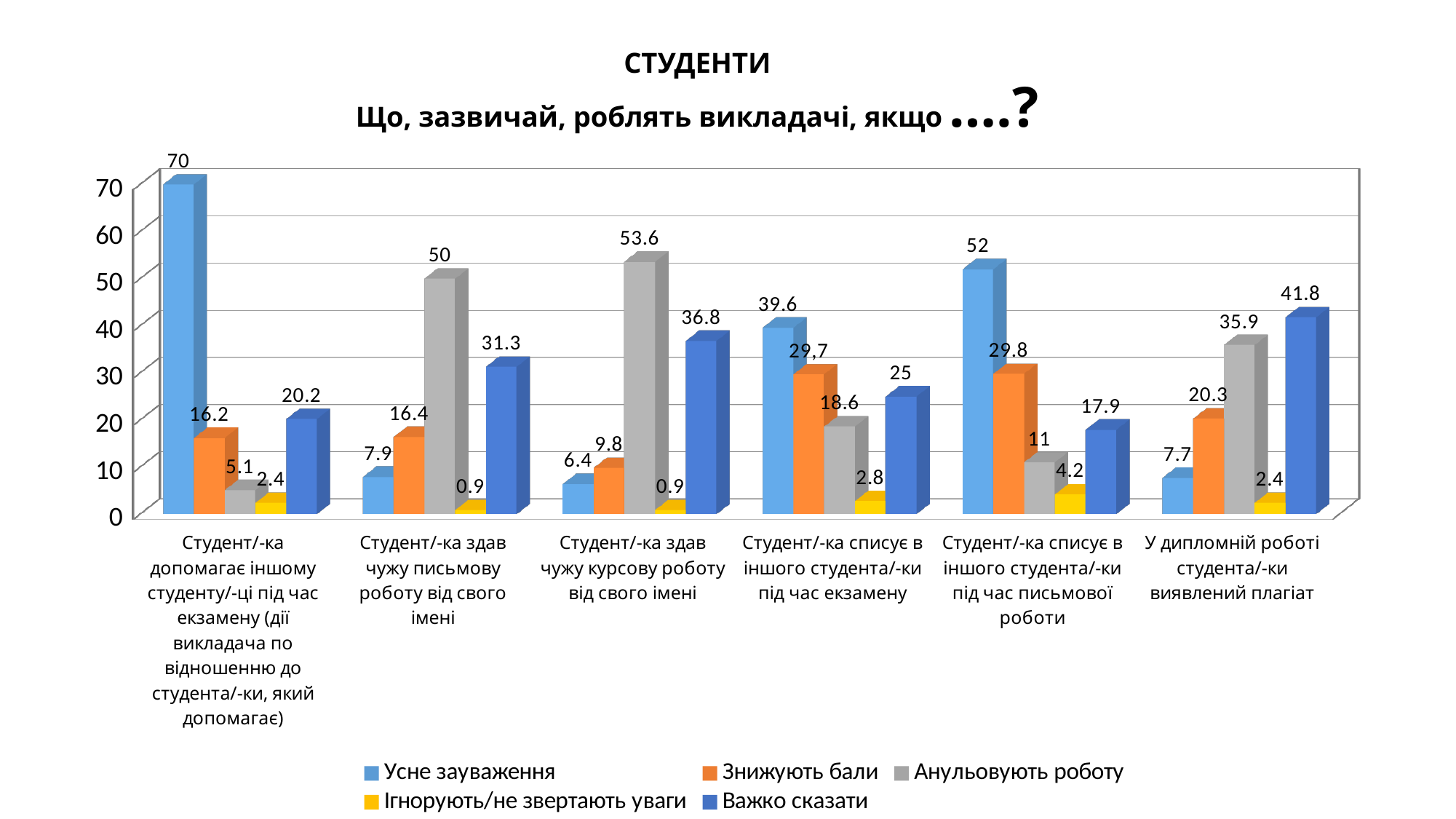
What is the value of "Усне зауваження" for the category "Студент/-ка допомагає іншому студенту/-ці під час екзамену"? 70 What is the value of "Важко сказати" for "У дипломній роботі студента/-ки виявлений плагіат"? 41.8 Which category has the lowest value for "Анульовують роботу"? Студент/-ка допомагає іншому студенту/-ці під час екзамену What is the value of "Ігнорують/не звертають уваги" for "Студент/-ка списує в іншого студента/-ки під час письмової роботи"? 4.2 For "Студент/-ка списує в іншого студента/-ки під час екзамену", which is larger: "Усне зауваження" or "Важко сказати"? Усне зауваження Which series is shown in yellow in the legend? Ігнорують/не звертають уваги How many categories are shown on the x axis? 6 What is the difference between "Анульовують роботу" and "Важко сказати" for "Студент/-ка здав чужу письмову роботу від свого імені"? 18.7 What type of chart is shown on the slide? Bar chart How many series does the legend list? 5 What is the value of "Анульовують роботу" for "Студент/-ка здав чужу курсову роботу від свого імені"? 53.6 Which category has the highest value for "Усне зауваження"? Студент/-ка допомагає іншому студенту/-ці під час екзамену